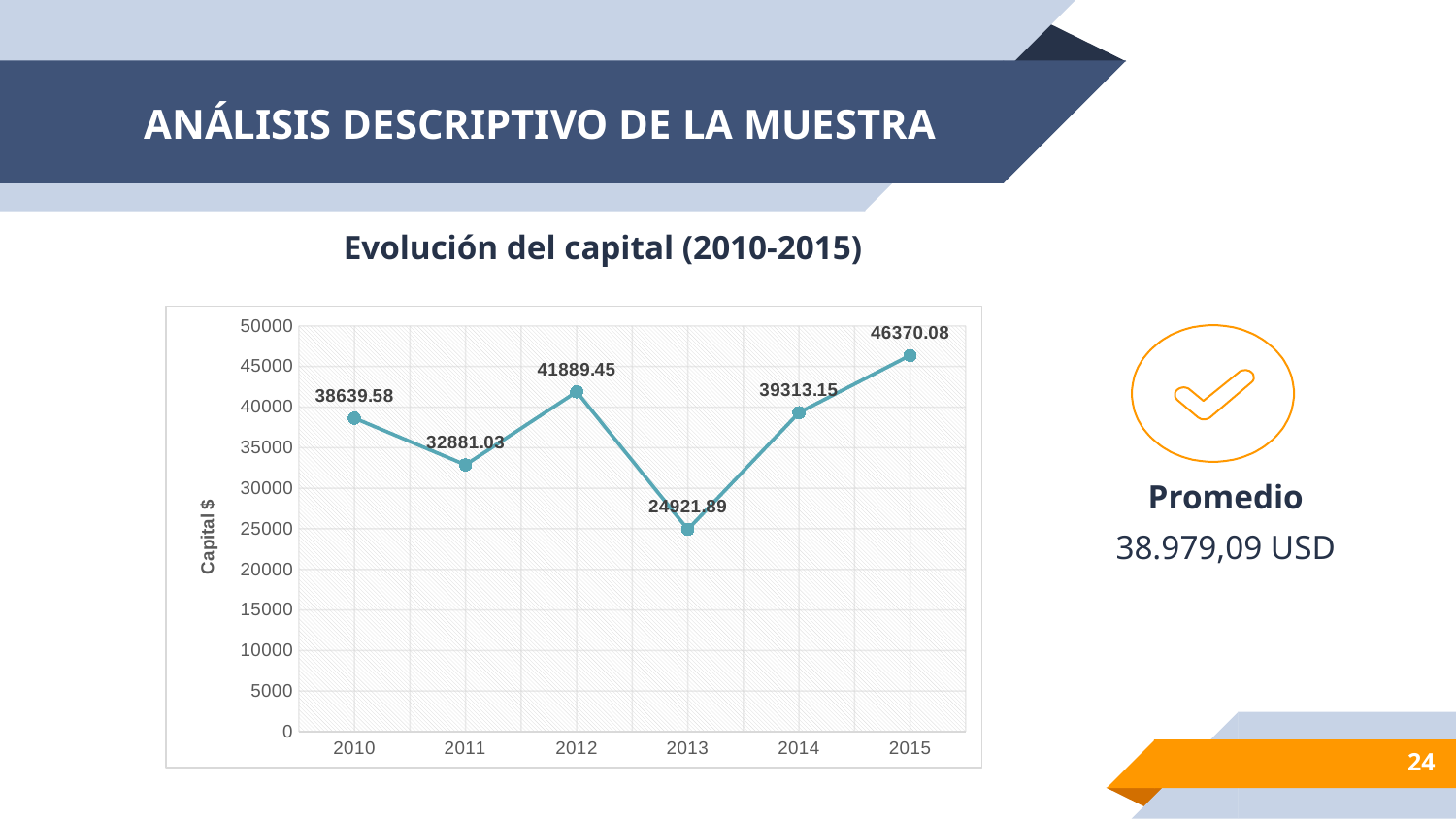
What is the capital value for 2015? 46370.08 What is the difference between the capital values for 2015 and 2013? 21448.19 What is the title of the chart? Evolución del capital (2010-2015) What is the capital value for 2013? 24921.89 What kind of chart is shown on the slide? line chart Which is larger, the capital value for 2010 or for 2014? 2014 Which year has the lowest capital value? 2013 Which year has the highest capital value? 2015 Is the capital value for 2011 greater or less than 35000? less What is the capital value for 2012? 41889.45 What is the difference between the capital values for 2012 and 2011? 9008.42 How many years are plotted on the chart? 6